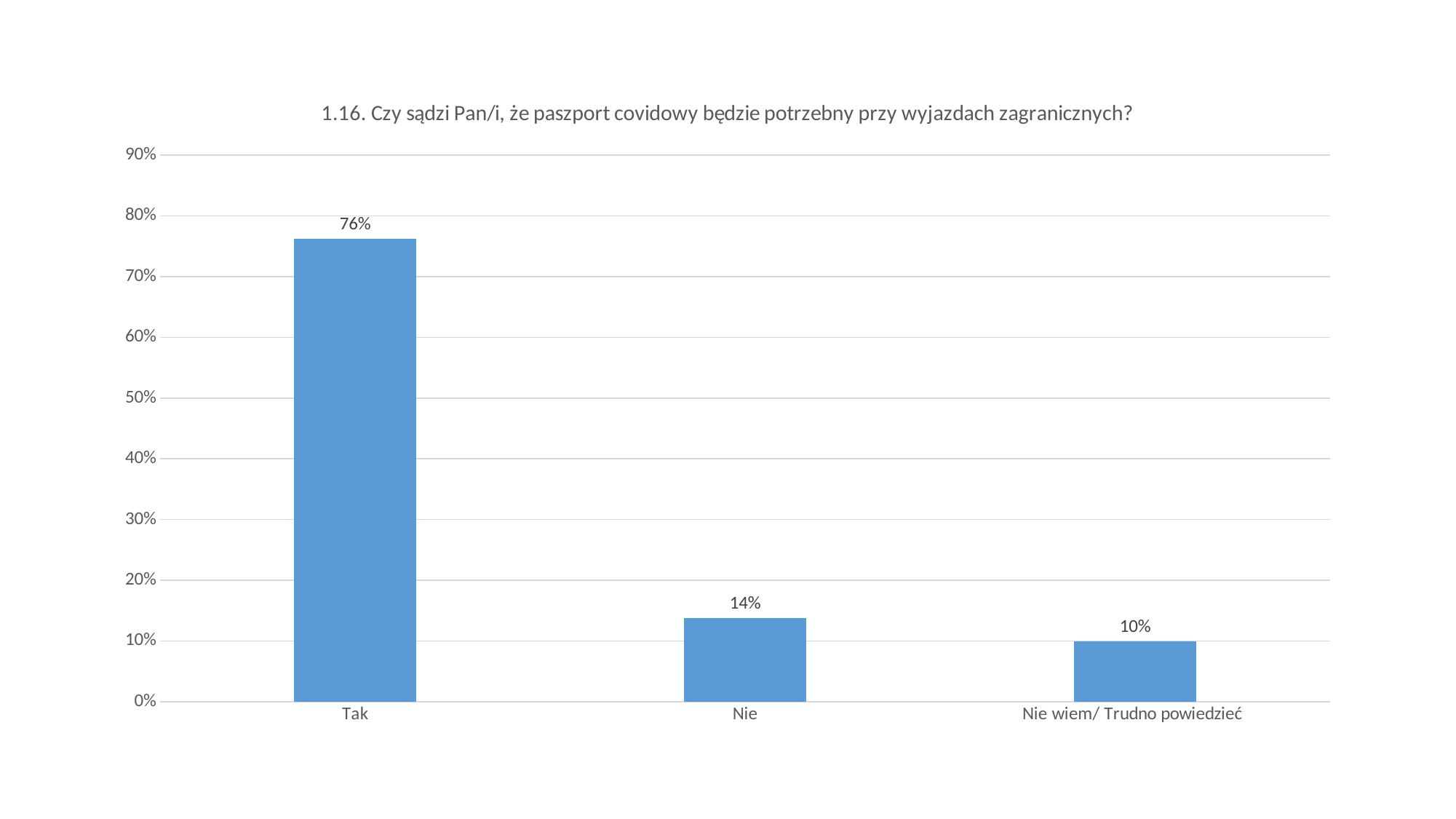
What is the value for "Nie"? 14% How many categories are shown on the x axis? 3 What is the title of the chart? 1.16. Czy sądzi Pan/i, że paszport covidowy będzie potrzebny przy wyjazdach zagranicznych? What kind of chart is shown on the slide? bar chart What is the difference between the values for "Nie" and "Nie wiem/ Trudno powiedzieć"? 4% What is the value for "Nie wiem/ Trudno powiedzieć"? 10% Which is larger, the value for "Nie" or the value for "Nie wiem/ Trudno powiedzieć"? Nie Is the value for "Tak" greater or less than 70%? greater Which category has the lowest value? Nie wiem/ Trudno powiedzieć What is the difference between the values for "Tak" and "Nie"? 62% What is the value for "Tak"? 76% Which category has the highest value? Tak